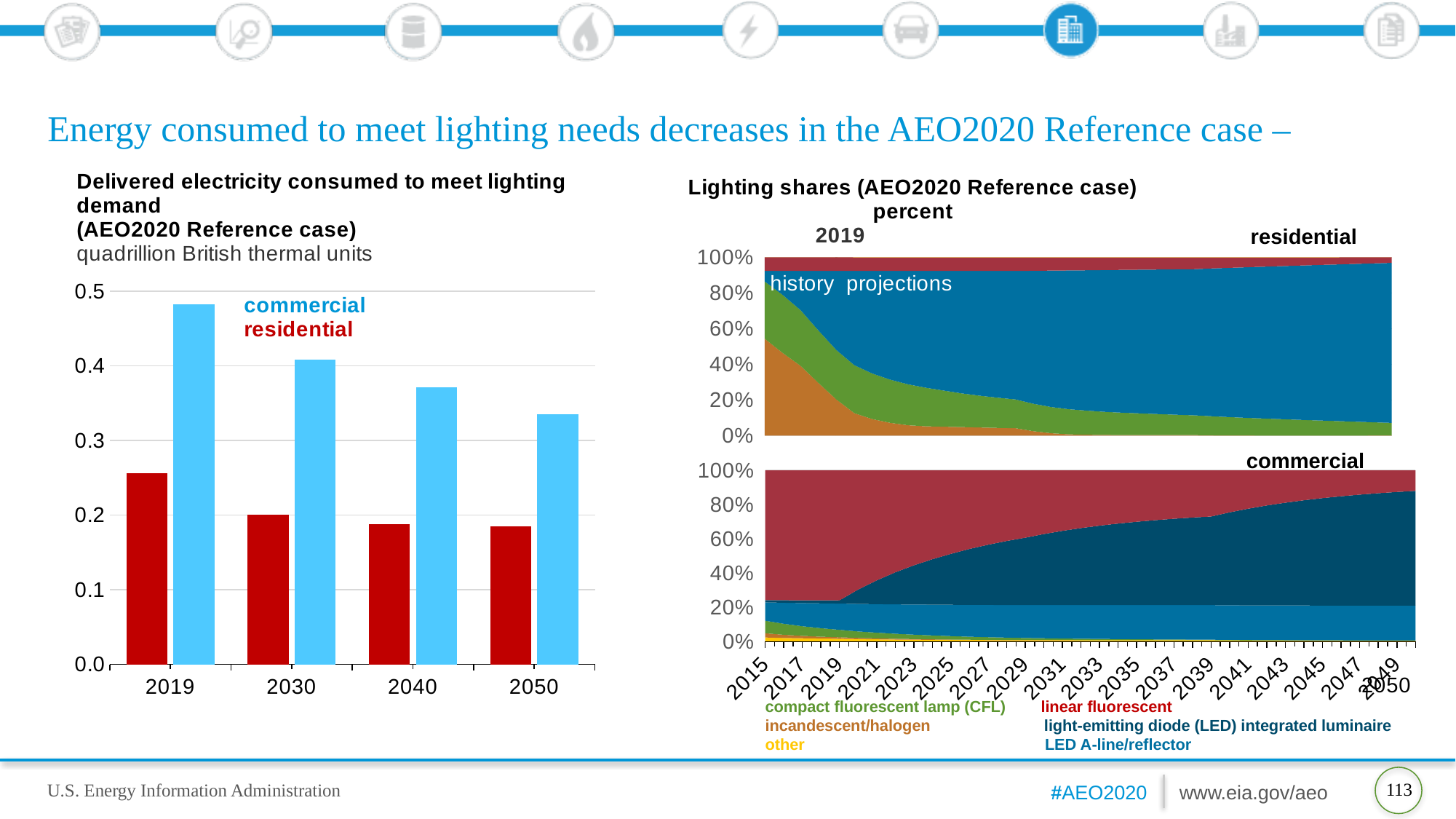
What kind of chart is the 'Delivered electricity consumed to meet lighting demand' chart on the left? bar chart What kind of chart is used for the 'Lighting shares (AEO2020 Reference case)' panels on the right? stacked area chart In the 'Delivered electricity consumed to meet lighting demand' bar chart, is the residential value for 2019 greater or less than 0.2? greater In the 'Delivered electricity consumed to meet lighting demand' bar chart, is the commercial value for 2050 greater or less than 0.3? greater How many series does the legend of the 'Delivered electricity consumed to meet lighting demand' bar chart list? 2 In the 'Delivered electricity consumed to meet lighting demand' bar chart, in which year is the commercial value highest? 2019 In the 'Delivered electricity consumed to meet lighting demand' bar chart, is the commercial value for 2019 greater or less than 0.4? greater How many years are shown on the x axis of the 'Delivered electricity consumed to meet lighting demand' bar chart? 4 In the 'Delivered electricity consumed to meet lighting demand' bar chart, which is larger in 2019, commercial or residential? commercial How many lighting types does the legend of the 'Lighting shares (AEO2020 Reference case)' chart list? 6 In the 'Delivered electricity consumed to meet lighting demand' bar chart, do the commercial values rise or fall from 2019 to 2050? fall In the 'Delivered electricity consumed to meet lighting demand' bar chart, in which year is the commercial value lowest? 2050